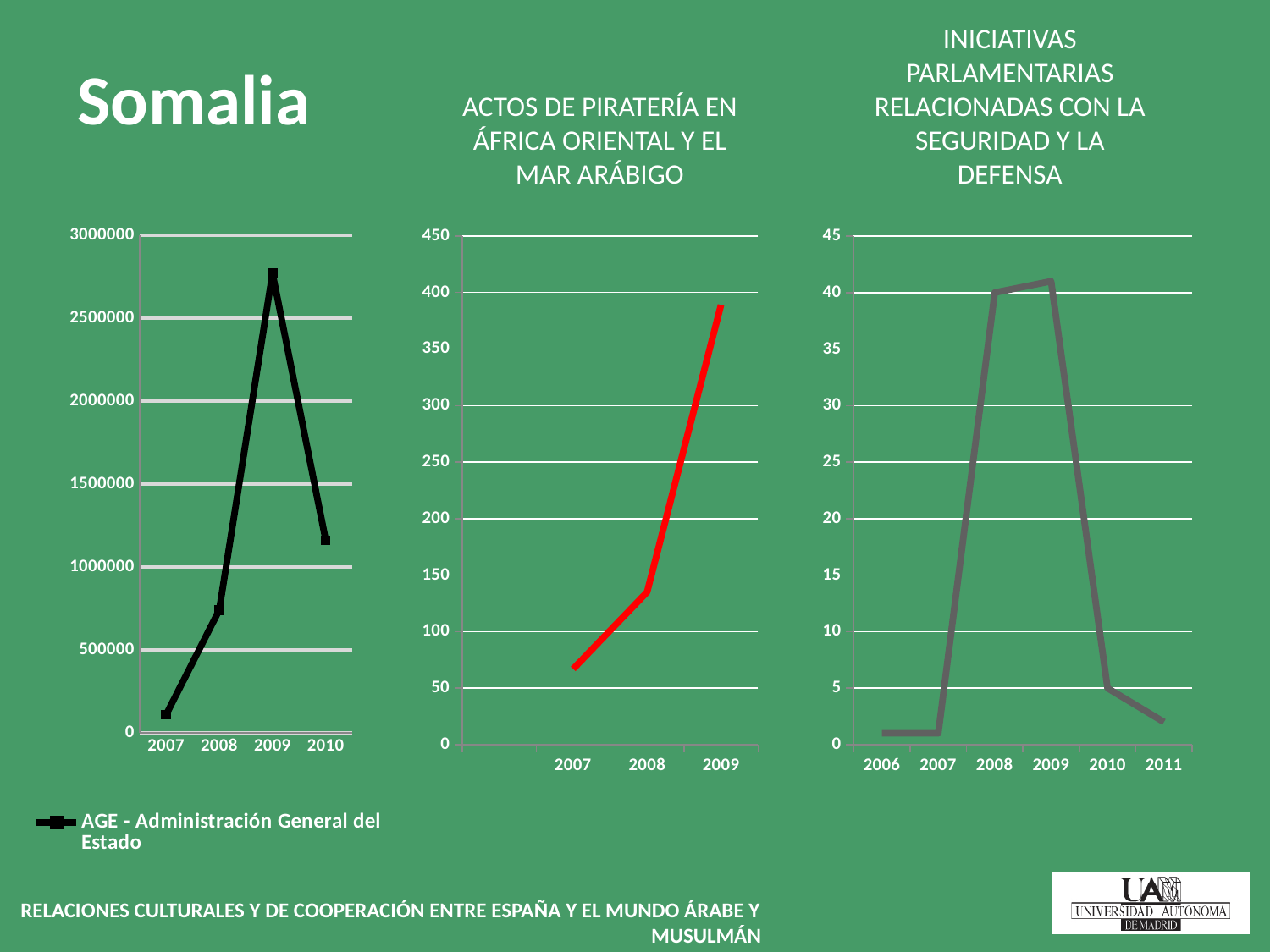
What colour is the line in the chart 'ACTOS DE PIRATERÍA EN ÁFRICA ORIENTAL Y EL MAR ARÁBIGO'? red In the left chart (AGE - Administración General del Estado), which year has the lowest value? 2007 In the chart 'INICIATIVAS PARLAMENTARIAS RELACIONADAS CON LA SEGURIDAD Y LA DEFENSA', how many years are shown on the x axis? 6 What kind of chart is the left chart with the legend 'AGE - Administración General del Estado'? line chart In the chart 'ACTOS DE PIRATERÍA EN ÁFRICA ORIENTAL Y EL MAR ARÁBIGO', do the values rise or fall from 2007 to 2009? rise In the chart 'INICIATIVAS PARLAMENTARIAS RELACIONADAS CON LA SEGURIDAD Y LA DEFENSA', is the value for 2008 greater or less than 35? greater In the chart 'INICIATIVAS PARLAMENTARIAS RELACIONADAS CON LA SEGURIDAD Y LA DEFENSA', which is larger, the value for 2009 or the value for 2010? 2009 In the chart 'ACTOS DE PIRATERÍA EN ÁFRICA ORIENTAL Y EL MAR ARÁBIGO', is the value for 2007 greater or less than 100? less In the left chart (AGE - Administración General del Estado), which year has the highest value? 2009 In the chart 'ACTOS DE PIRATERÍA EN ÁFRICA ORIENTAL Y EL MAR ARÁBIGO', is the value for 2009 greater or less than 350? greater In the left chart (AGE - Administración General del Estado), how many years are shown on the x axis? 4